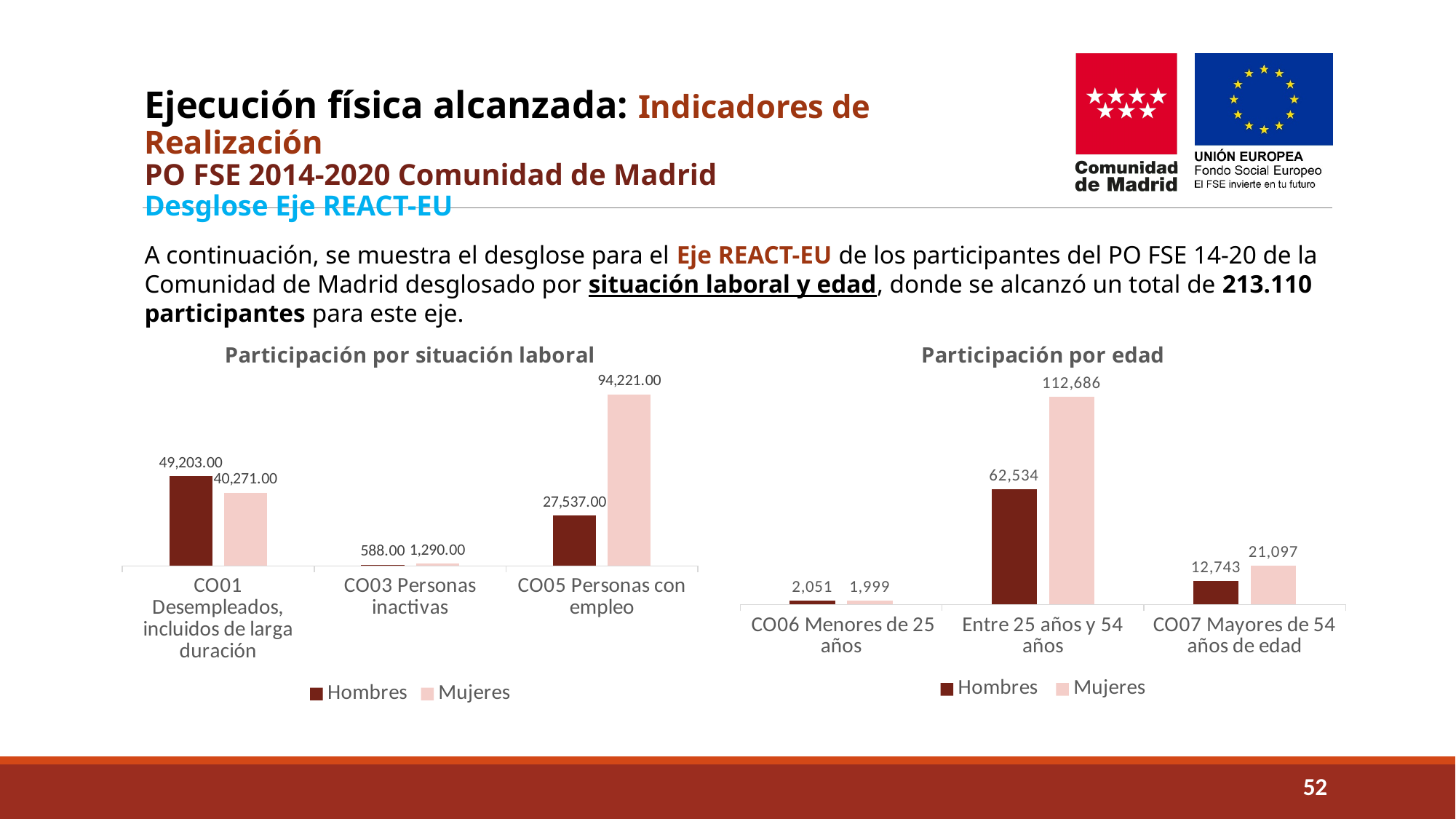
In the 'Participación por situación laboral' chart, what is the difference between the Mujeres and Hombres values for CO05 Personas con empleo? 66,684.00 In the 'Participación por situación laboral' chart, how many series does the legend list? 2 In the 'Participación por edad' chart, how many age categories are shown on the x axis? 3 In the 'Participación por situación laboral' chart, which category has the lowest Hombres value? CO03 Personas inactivas In the 'Participación por edad' chart, what is the difference between the Mujeres and Hombres values for CO07 Mayores de 54 años de edad? 8,354 In the 'Participación por situación laboral' chart, which is larger for CO01 Desempleados: Hombres or Mujeres? Hombres In the 'Participación por situación laboral' chart, what is the Mujeres value for CO05 Personas con empleo? 94,221.00 In the 'Participación por edad' chart, what is the Hombres value for CO07 Mayores de 54 años de edad? 12,743 In the 'Participación por edad' chart, what is the Mujeres value for Entre 25 años y 54 años? 112,686 In the 'Participación por edad' chart, which category has the highest Mujeres value? Entre 25 años y 54 años In the 'Participación por situación laboral' chart, what is the Hombres value for CO01 Desempleados, incluidos de larga duración? 49,203.00 What type of chart is 'Participación por edad'? Bar chart